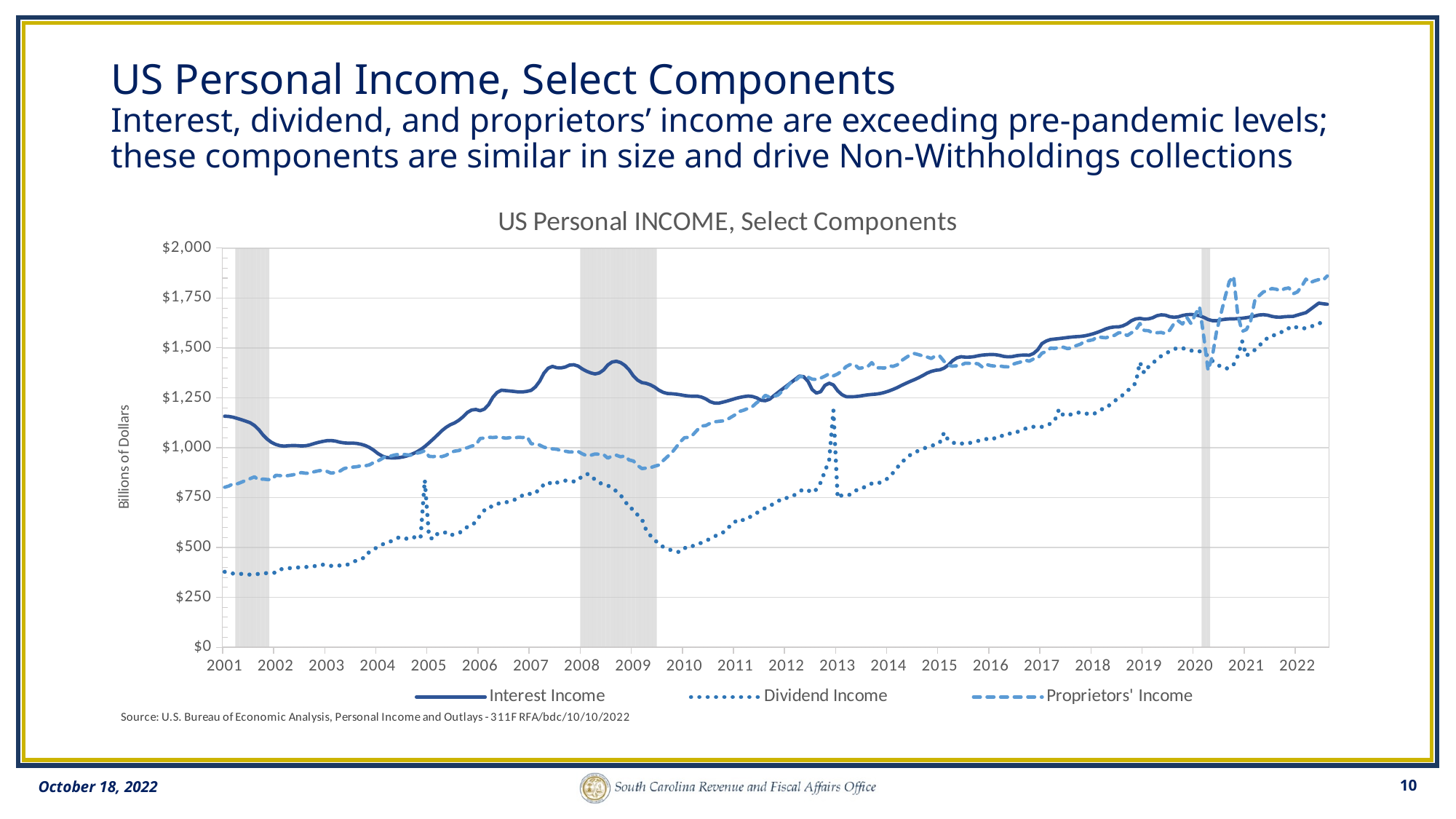
What is the label on the vertical axis of the chart? Billions of Dollars How many series does the chart legend list? 3 Is the value for Dividend Income at the start of 2001 greater or less than $500? less What kind of chart is shown on the slide? Line chart Which series has the highest value at the end of 2022? Proprietors' Income How many year labels are shown along the x axis? 22 What is the title of the chart? US Personal INCOME, Select Components Which series has the lowest value at the start of 2001? Dividend Income Is the value for Dividend Income in 2010 greater or less than $750? less Is the value for Interest Income at the start of 2001 greater or less than $1,000? greater Does Dividend Income generally rise or fall from 2010 to 2022? Rise